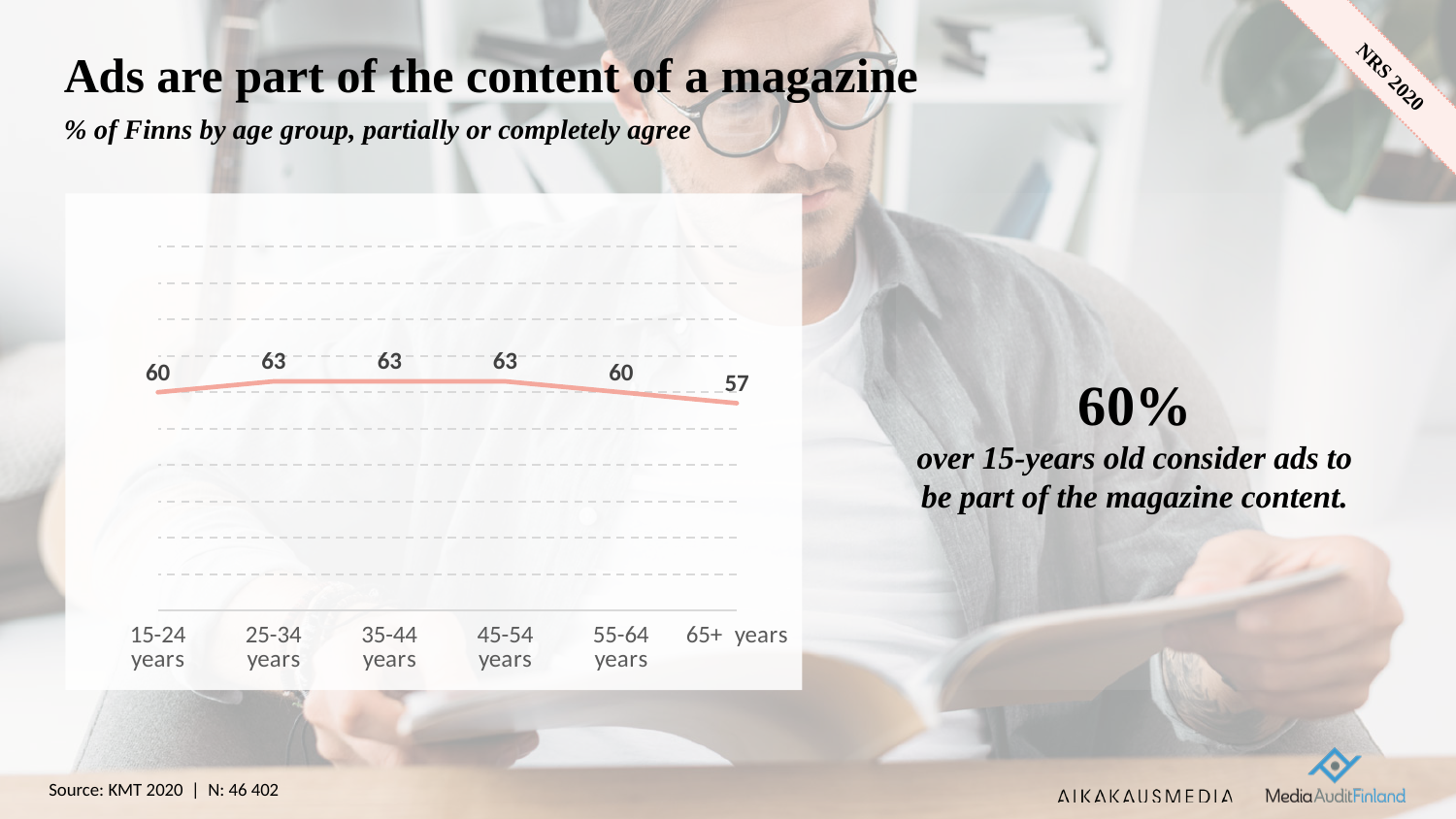
What is the title of the slide's chart? Ads are part of the content of a magazine Which is larger, the value for 35-44 years or the value for 55-64 years? 35-44 years What is the value for the 45-54 years age group? 63 How many age groups are plotted on the chart? 6 What kind of chart is shown on the slide? Line chart How many age groups share the highest value of 63? 3 Do the values rise or fall from 45-54 years to 65+ years? Fall Which age group has the lowest value? 65+ years What is the difference between the values for 15-24 years and 25-34 years? 3 What is the value for the 15-24 years age group? 60 What is the value for the 65+ years age group? 57 What is the difference between the values for 25-34 years and 65+ years? 6